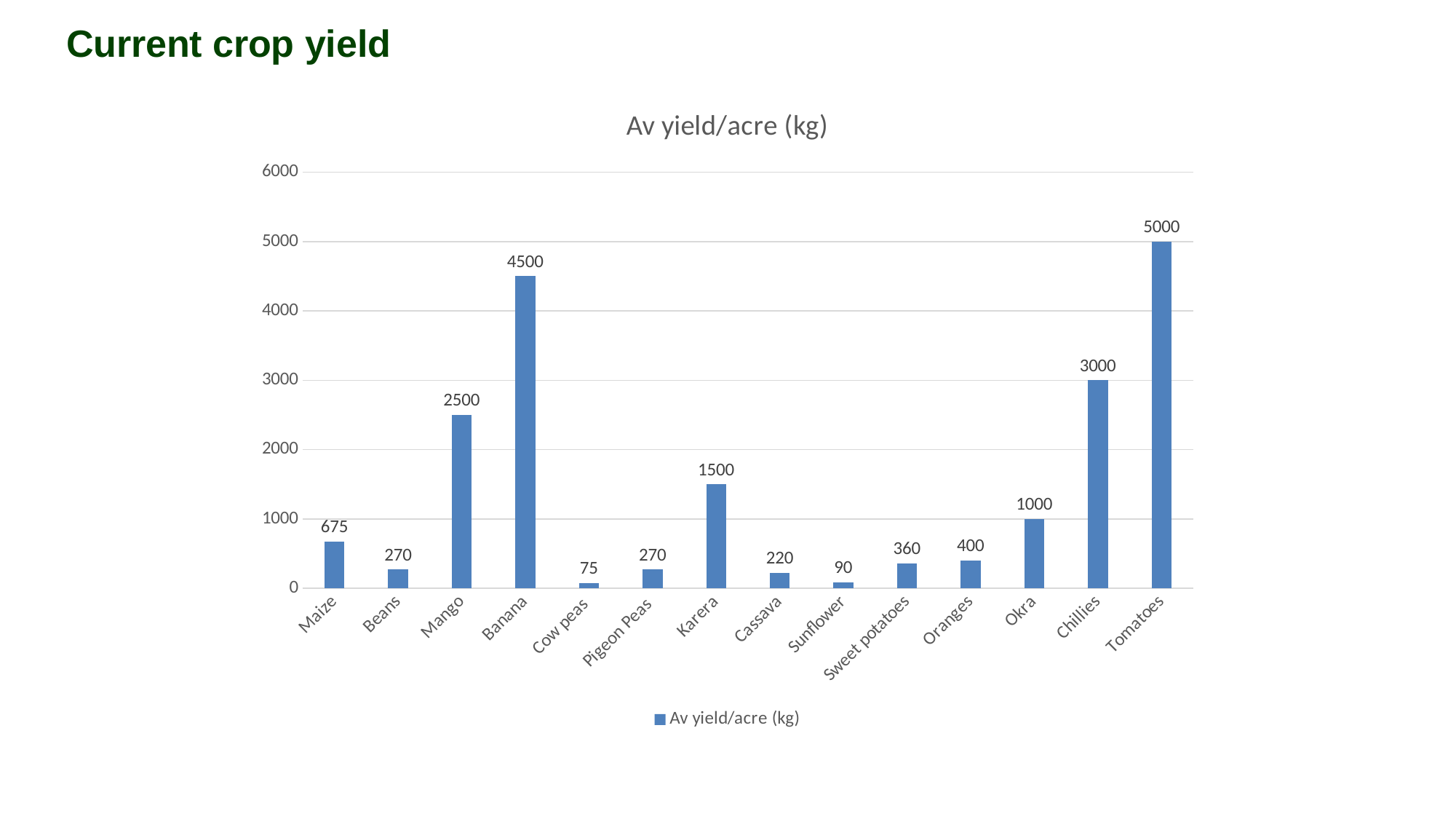
What is the average yield per acre for Sweet potatoes? 360 Which crop has the highest average yield per acre? Tomatoes Which has a higher average yield per acre, Oranges or Cassava? Oranges What is the title of the chart? Av yield/acre (kg) What is the average yield per acre for Maize? 675 Is the value for Chillies greater or less than 2000? greater What is the average yield per acre for Karera? 1500 What is the difference in average yield per acre between Chillies and Okra? 2000 Which crop has the lowest average yield per acre? Cow peas What is the difference in average yield per acre between Banana and Mango? 2000 How many crops are shown on the chart? 14 What type of chart is shown on the slide? Bar chart